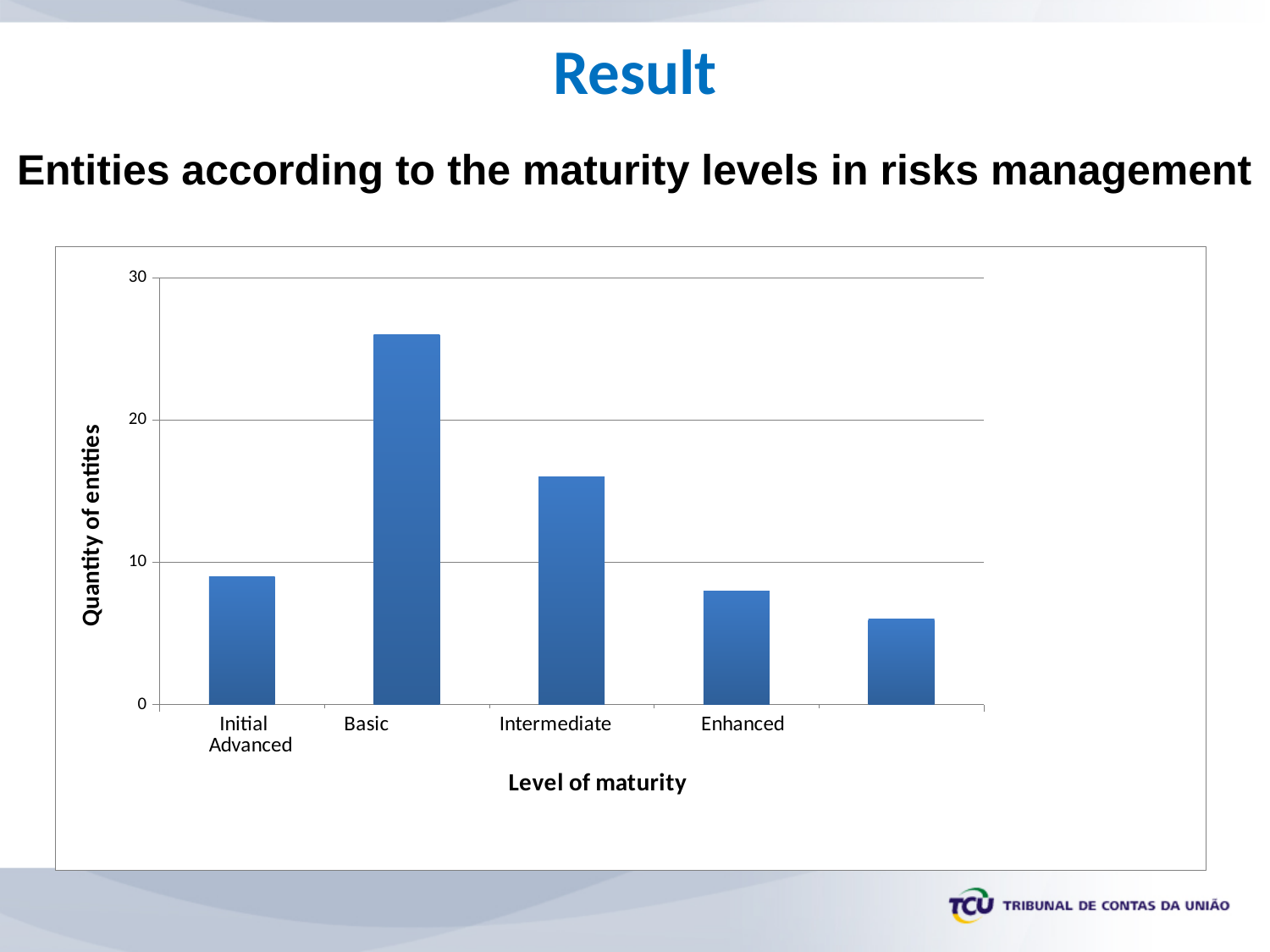
Is the value for Basic greater or less than 20? greater Is the value for Intermediate greater or less than 20? less Which has more entities, Basic or Intermediate? Basic Which level of maturity has the highest quantity of entities? Basic What is the title of the horizontal axis? Level of maturity What is the title of the vertical axis? Quantity of entities How many bars are plotted in the chart? 5 Is the value for Enhanced greater or less than 10? less What kind of chart is shown on the slide? bar chart Which has more entities, Intermediate or Enhanced? Intermediate